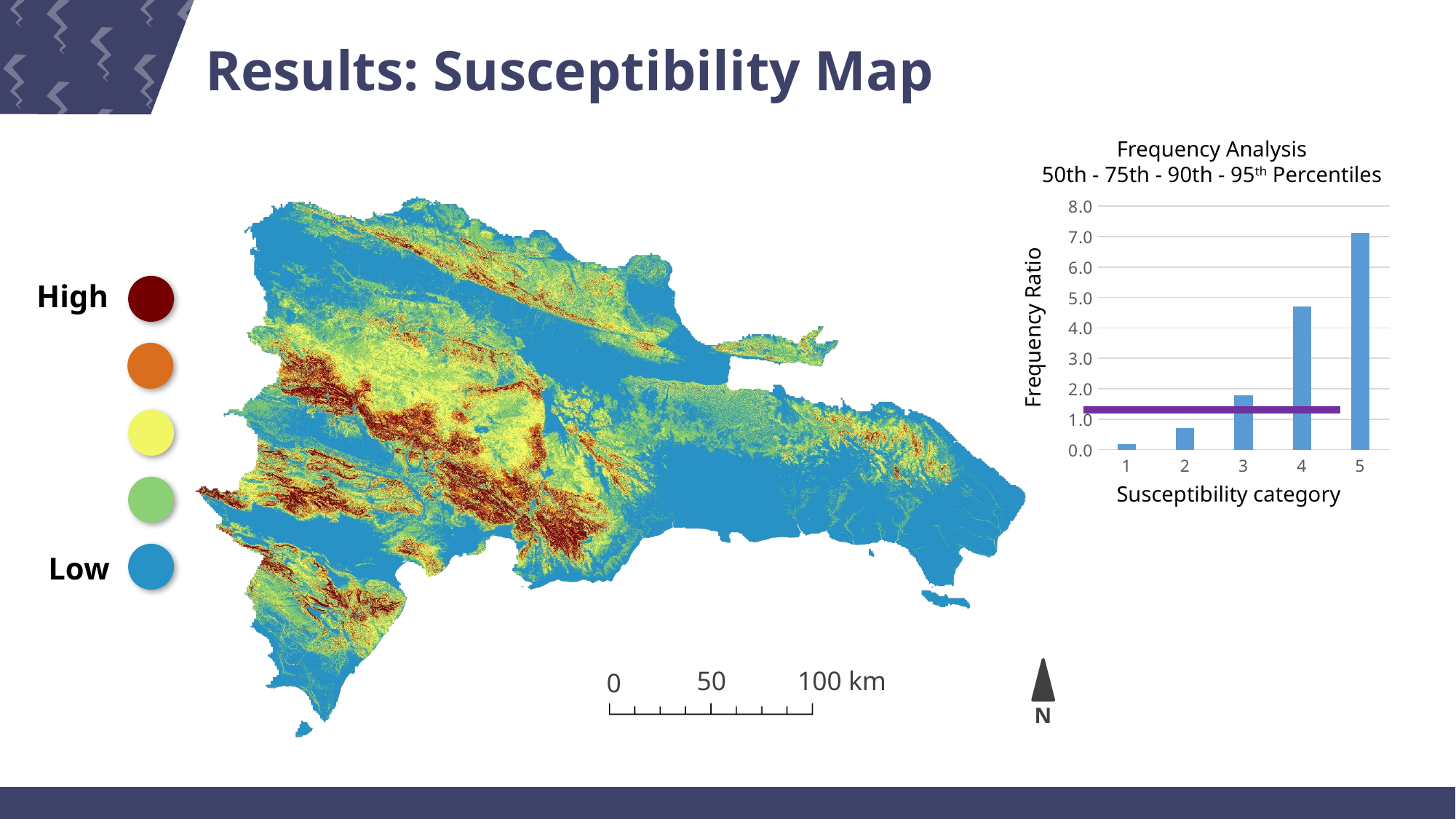
In the Frequency Analysis chart, is the frequency ratio for susceptibility category 4 greater or less than 4.0? greater How many susceptibility categories are plotted on the x axis of the Frequency Analysis chart? 5 In the Frequency Analysis chart, is the frequency ratio for susceptibility category 2 greater or less than 1.0? less In the Frequency Analysis chart, which susceptibility category has the highest frequency ratio? 5 In the Frequency Analysis chart, which susceptibility category has the lowest frequency ratio? 1 In the Frequency Analysis chart, do the frequency ratios rise or fall as the susceptibility category increases from 1 to 5? rise What is the label of the y axis on the Frequency Analysis chart? Frequency Ratio In the Frequency Analysis chart, is the frequency ratio for susceptibility category 3 greater or less than 1.0? greater What kind of chart is the Frequency Analysis chart on the right of the slide? bar chart In the Frequency Analysis chart, which has the larger frequency ratio, susceptibility category 3 or category 4? 4 What is the label of the x axis on the Frequency Analysis chart? Susceptibility category